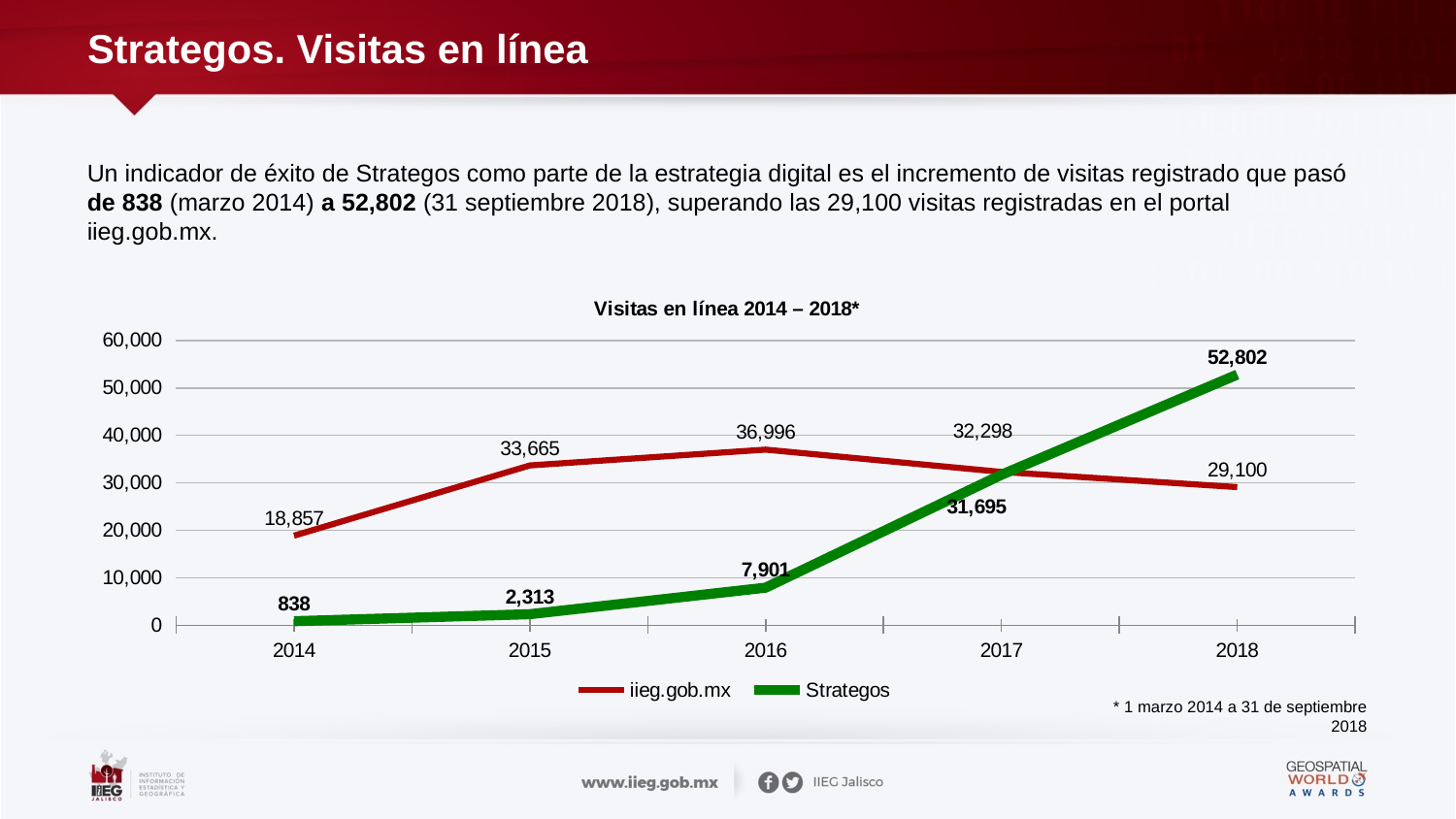
What is the difference between Strategos and iieg.gob.mx in 2018? 23,702 What is the value for Strategos in 2018? 52,802 In which year is the Strategos series lowest? 2014 How many years are plotted on the x axis? 5 What is the value for Strategos in 2014? 838 What is the value for iieg.gob.mx in 2016? 36,996 What is the title of the chart? Visitas en línea 2014 – 2018* In which year is the iieg.gob.mx series highest? 2016 Which series has the larger value in 2017, iieg.gob.mx or Strategos? iieg.gob.mx How many series does the legend list? 2 What type of chart is shown on the slide? Line chart Does the Strategos series rise or fall from 2014 to 2018? Rise